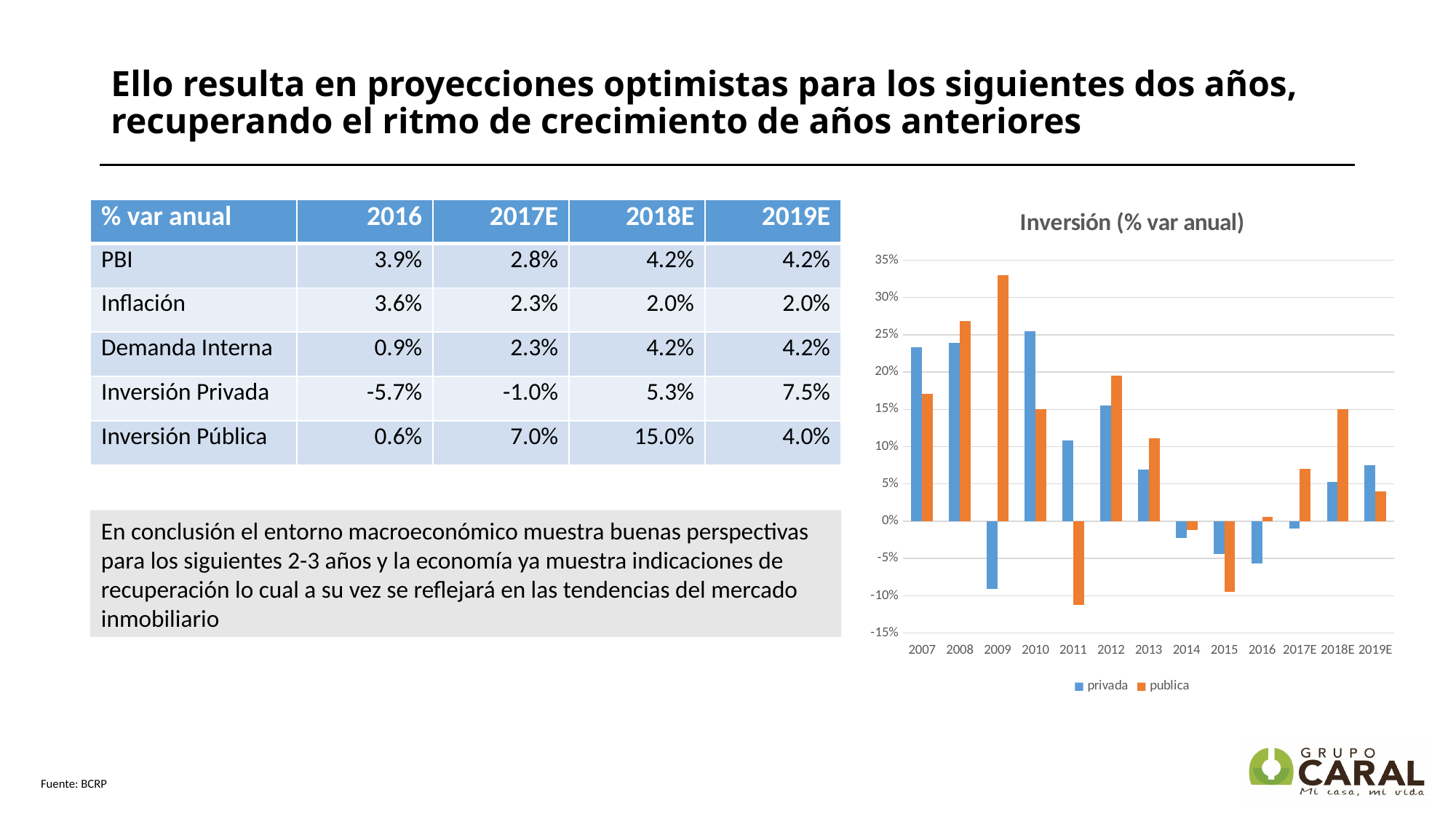
In the 'Inversión (% var anual)' chart, is the 'privada' value for 2007 greater or less than 20%? greater In the 'Inversión (% var anual)' chart, which year has the highest value for 'publica'? 2009 What kind of chart is the 'Inversión (% var anual)' chart? bar chart In the 'Inversión (% var anual)' chart, does the 'privada' series rise or fall from 2010 to 2015? fall How many years are shown on the x axis of the 'Inversión (% var anual)' chart? 13 How many series does the legend of the 'Inversión (% var anual)' chart list? 2 What is the title of the chart on the right of the slide? Inversión (% var anual) In the 'Inversión (% var anual)' chart, which is larger in 2009: 'privada' or 'publica'? publica In the 'Inversión (% var anual)' chart, which year has the lowest value for 'privada'? 2009 In the 'Inversión (% var anual)' chart, which is larger in 2010: 'privada' or 'publica'? privada In the 'Inversión (% var anual)' chart, what is the 'publica' value for 2018E? 15% In the 'Inversión (% var anual)' chart, is the 'publica' value for 2011 greater or less than -5%? less